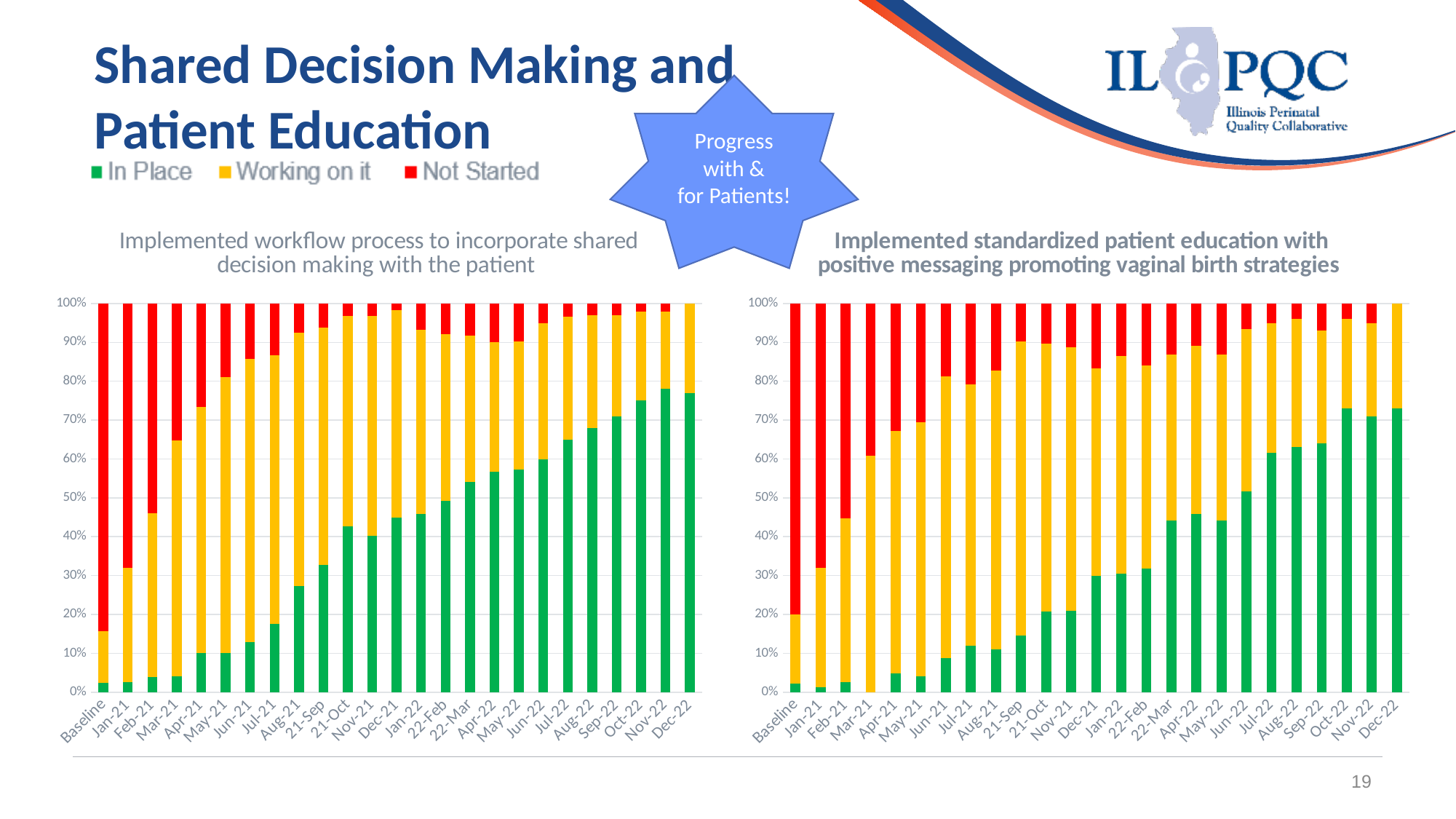
What are the three series named in the legend? In Place, Working on it, Not Started In the right chart (standardized patient education), is the 'In Place' value for Dec-22 greater or less than 60%? greater In the left chart (shared decision making workflow), which category has the largest 'Not Started' share? Baseline In the right chart (standardized patient education), is the 'In Place' value for Baseline greater or less than 10%? less In the left chart (shared decision making workflow), is the 'In Place' value for Aug-21 greater or less than 30%? less In the right chart (standardized patient education), does the 'Not Started' share generally rise or fall from Baseline to Dec-22? fall How many series does the legend list for the charts on this slide? 3 How many categories are shown along the x axis of the right chart, titled 'Implemented standardized patient education with positive messaging promoting vaginal birth strategies'? 25 In the left chart (shared decision making workflow), does the 'In Place' share generally rise or fall from Baseline to Dec-22? rise What kind of chart is used on the left, titled 'Implemented workflow process to incorporate shared decision making with the patient'? Stacked bar chart In the left chart (shared decision making workflow), which is larger: the 'In Place' value for Jan-21 or for Jul-21? Jul-21